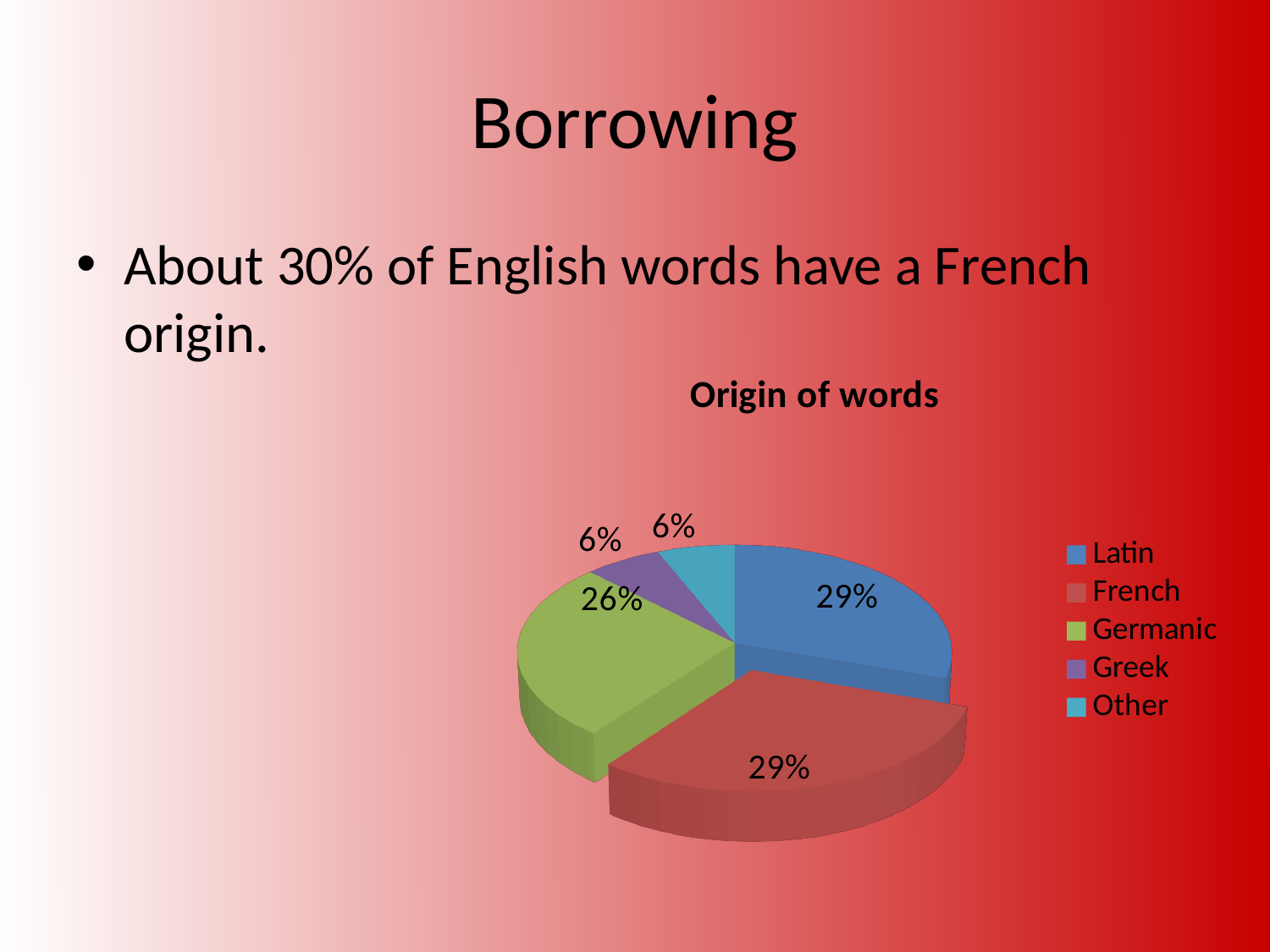
What is the difference between the share for Latin and the share for Germanic? 3% What share of the pie does Other represent? 6% What share of the pie does Latin represent? 29% What is the difference between the share for French and the share for Other? 23% What share of the pie does Germanic represent? 26% What is the title of the chart? Origin of words What kind of chart is shown on the slide? pie chart Which is larger, the share for Germanic or the share for Greek? Germanic How many categories does the pie chart show? 5 Which category is shown in green in the pie chart? Germanic